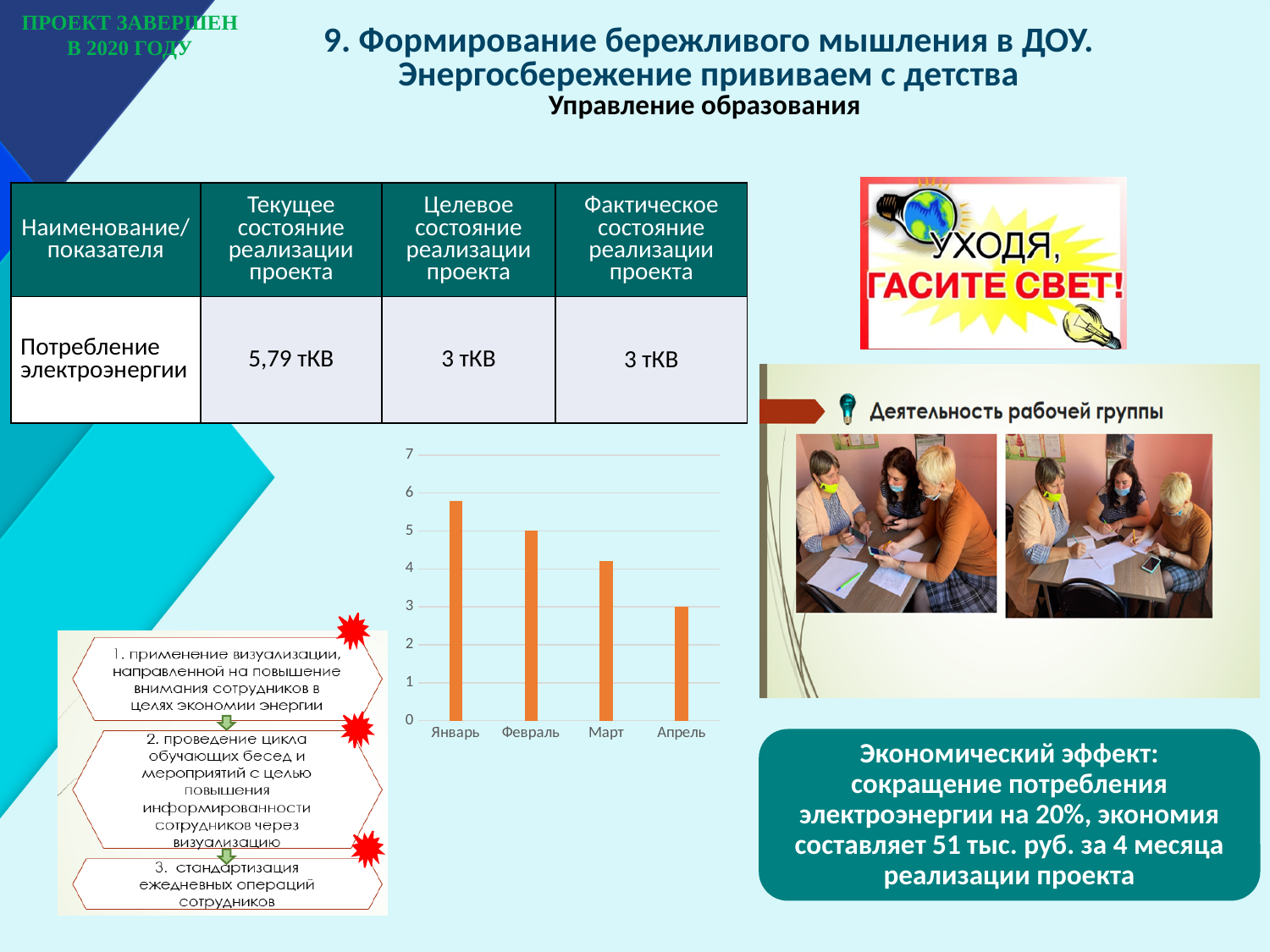
How many categories are shown on the x axis of the bar chart? 4 Is the value for Март greater or less than 5? less What kind of chart is shown on the slide? bar chart What is the highest value shown on the vertical axis of the bar chart? 7 Is the value for Январь greater or less than 5? greater Is the value for Апрель greater or less than 4? less Which month has the highest bar in the chart? Январь Which is larger in the bar chart, the value for Февраль or the value for Март? Февраль Which is larger in the bar chart, the value for Апрель or the value for Январь? Январь Which month has the lowest bar in the chart? Апрель Do the values in the bar chart rise or fall from Январь to Апрель? fall